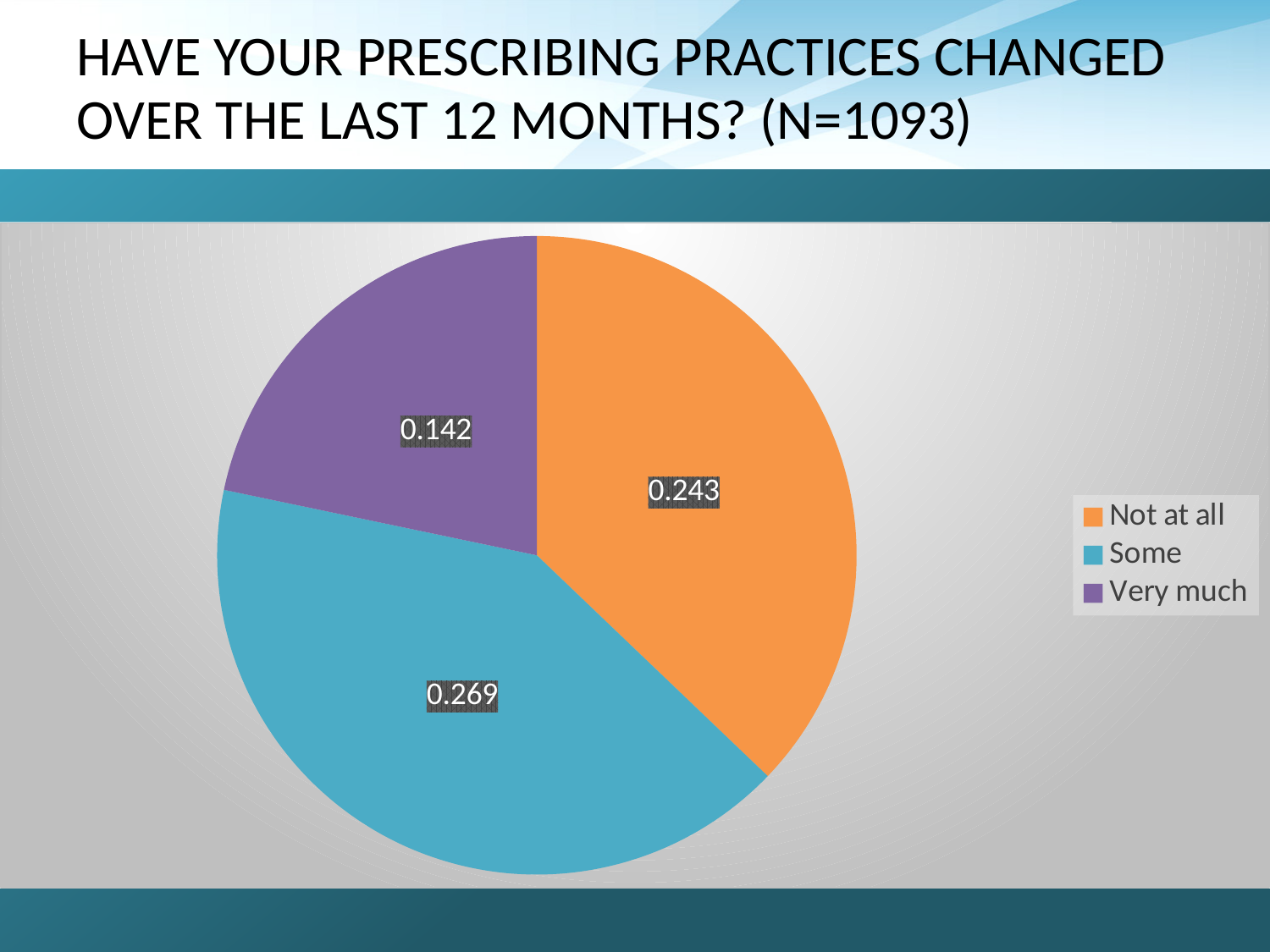
How many slices does the pie chart have? 3 What is the difference between the values for Some and Not at all? 0.026 What value is shown for the Some slice? 0.269 Which category has the smallest slice? Very much What value is shown for the Not at all slice? 0.243 What colour is the Very much slice? Purple Which category has the largest slice? Some What kind of chart is shown on the slide? Pie chart What is the difference between the values for Not at all and Very much? 0.101 What sample size (N) is given in the slide title? 1093 Which is larger, the value for Not at all or the value for Very much? Not at all What value is shown for the Very much slice? 0.142